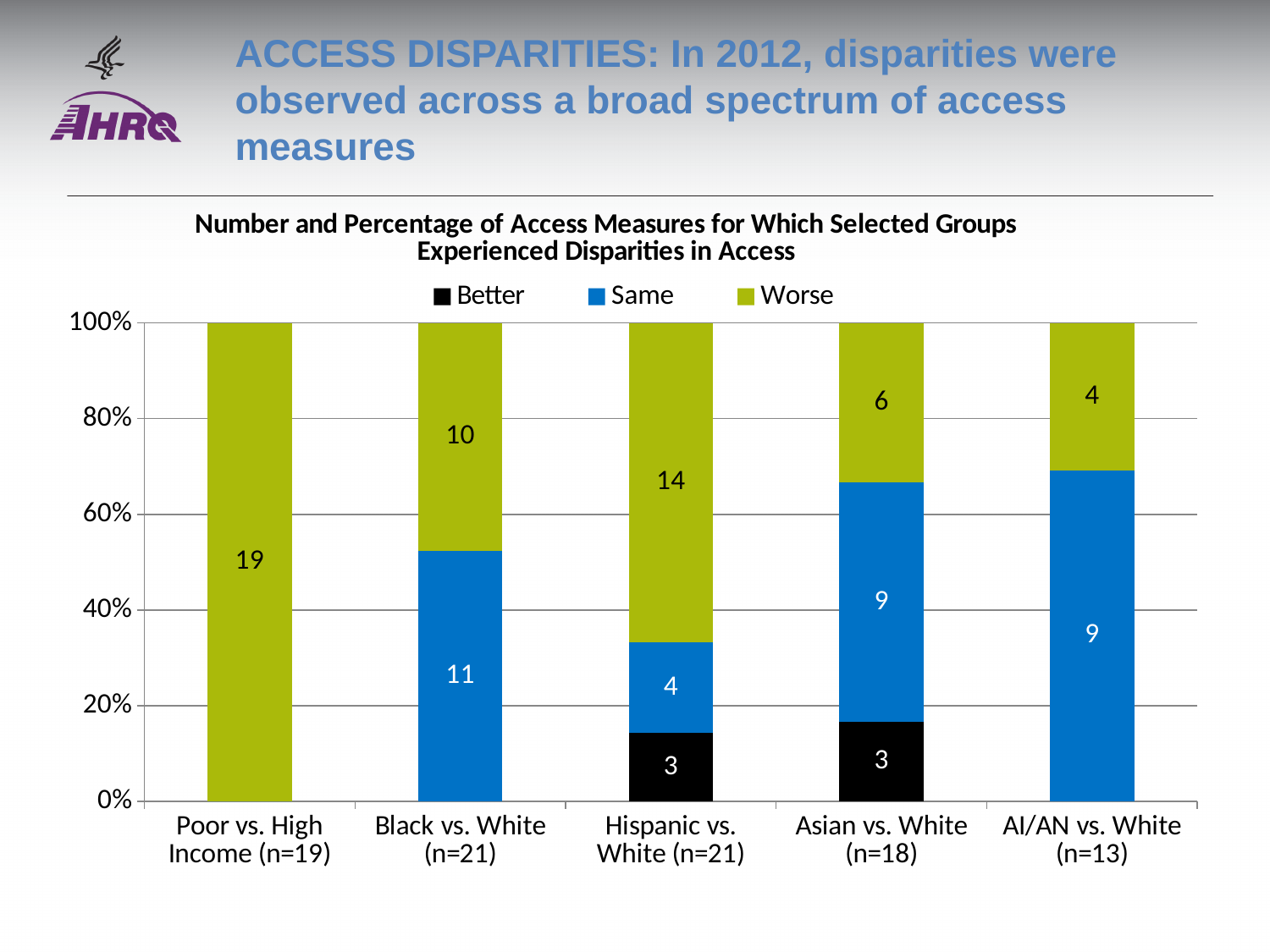
Which is larger for Asian vs. White: the 'Same' count or the 'Worse' count? Same What is the number of 'Better' measures for Hispanic vs. White? 3 How many series does the legend list? 3 What is the number of 'Worse' measures for AI/AN vs. White? 4 Which group has the highest number of 'Worse' measures? Poor vs. High Income How many comparison groups (categories) are shown on the x axis? 5 What is the difference between the 'Worse' and 'Same' counts for Hispanic vs. White? 10 What is the total of the labelled segments in the Asian vs. White bar? 18 What is the number of 'Same' measures for Black vs. White? 11 What kind of chart is shown on the slide? Stacked bar chart What is the number of 'Worse' measures for Poor vs. High Income? 19 Is the 'Worse' share of the AI/AN vs. White bar greater or less than 40%? less